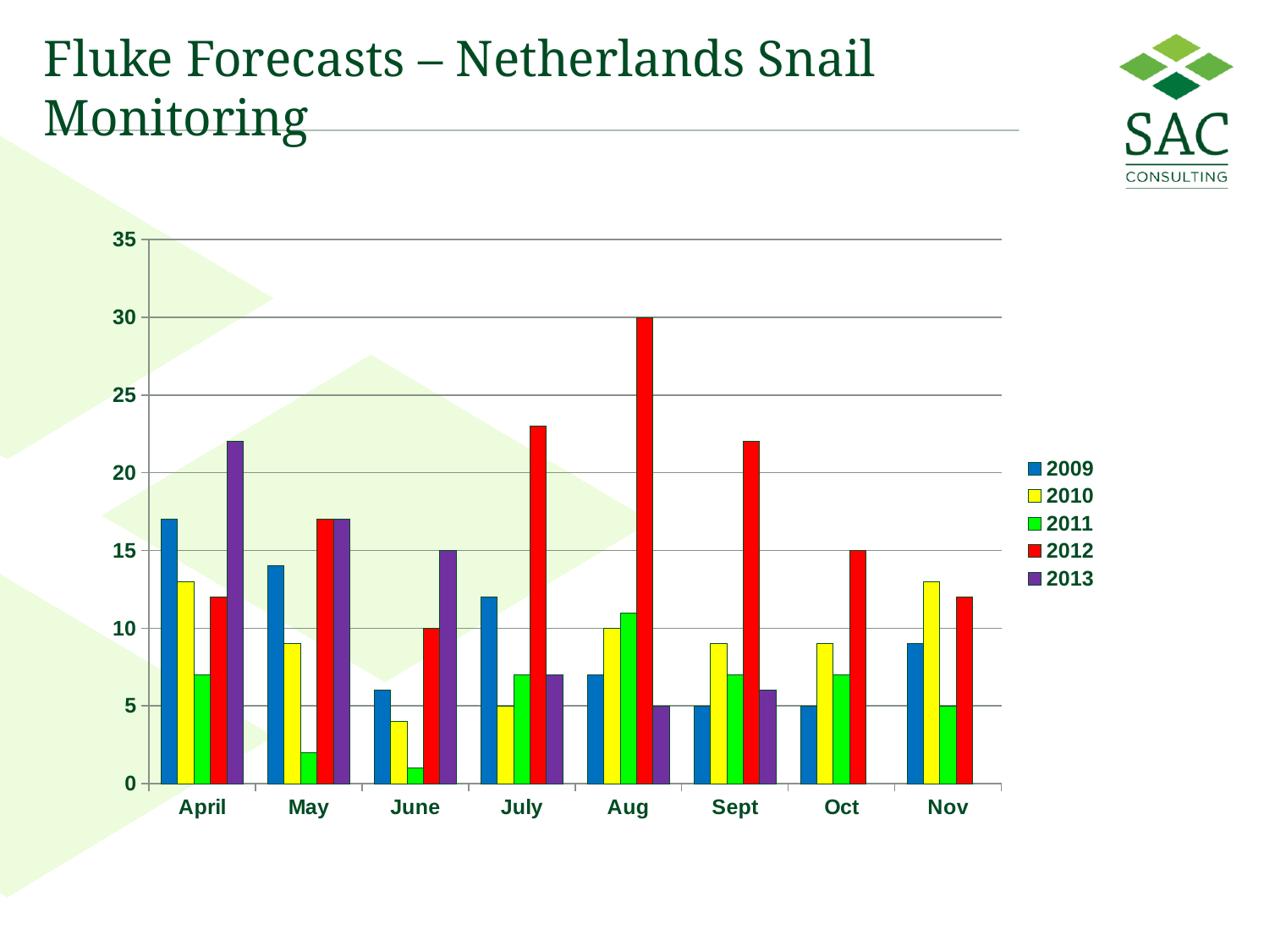
What is the 2013 value for June? 15 How many months are shown on the x axis? 8 In which month is the 2012 value highest? Aug Do the 2012 values rise or fall from Aug to Nov? fall What is the 2012 value for Oct? 15 What is the 2012 value for Aug? 30 What type of chart is shown on the slide? bar chart In April, which is larger: the 2009 value or the 2010 value? 2009 Is the 2012 value for July greater or less than 20? greater How many series does the legend list? 5 Is the 2011 value for May greater or less than 5? less In which month is the 2011 value lowest? June